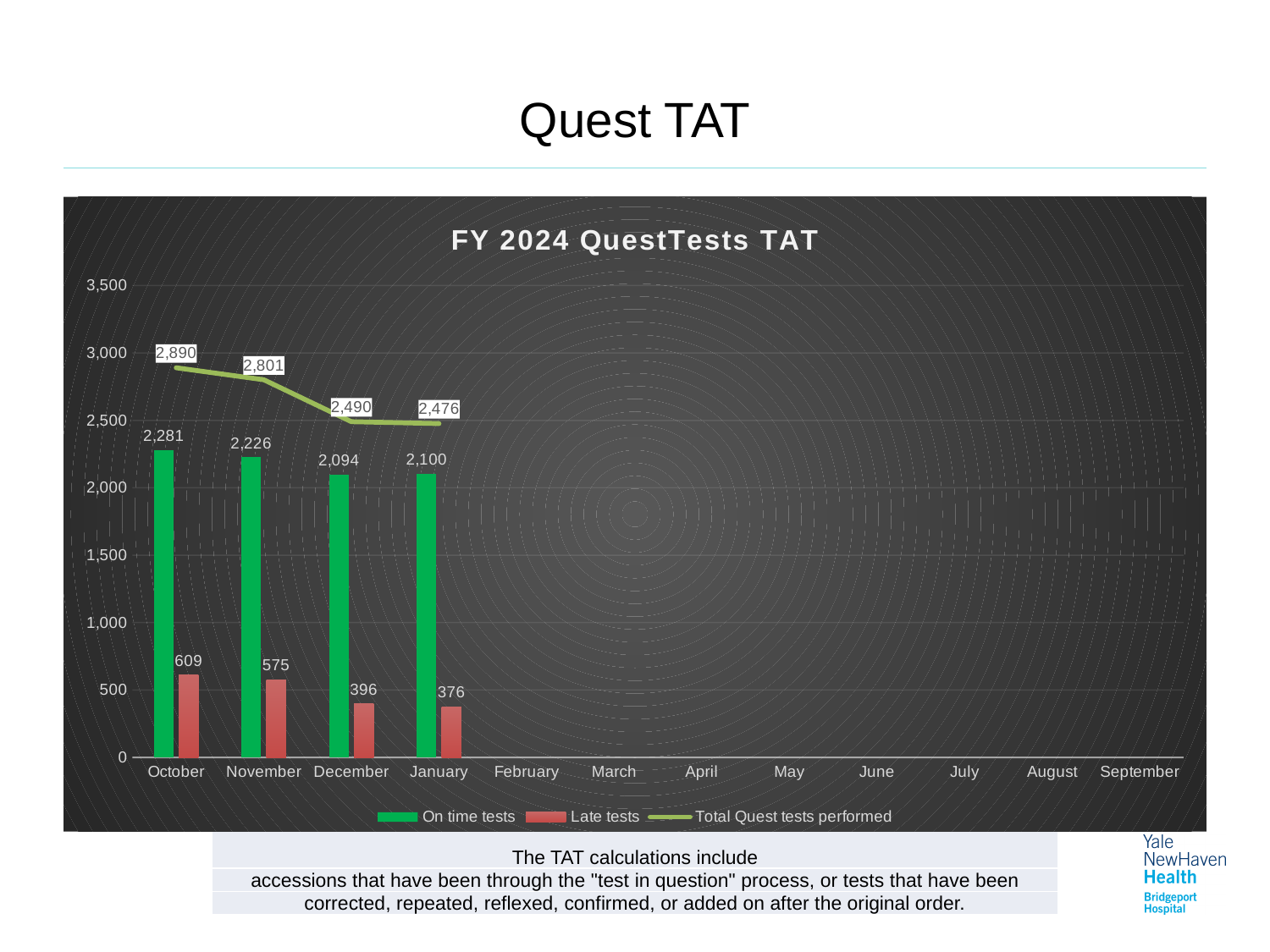
Does the Total Quest tests performed line rise or fall from October to January? fall What is the difference between Late tests in October and Late tests in January? 233 Which is larger: On time tests in December or On time tests in January? January What is the value of On time tests for October? 2,281 Is the value of On time tests for November greater or less than 2,000? greater What is the value of Late tests for December? 396 Which month has the highest number of Late tests? October Which month has the lowest Total Quest tests performed? January What is the title of the chart? FY 2024 QuestTests TAT How many series does the legend list? 3 How many months have data plotted on the chart? 4 What is the Total Quest tests performed value for November? 2,801